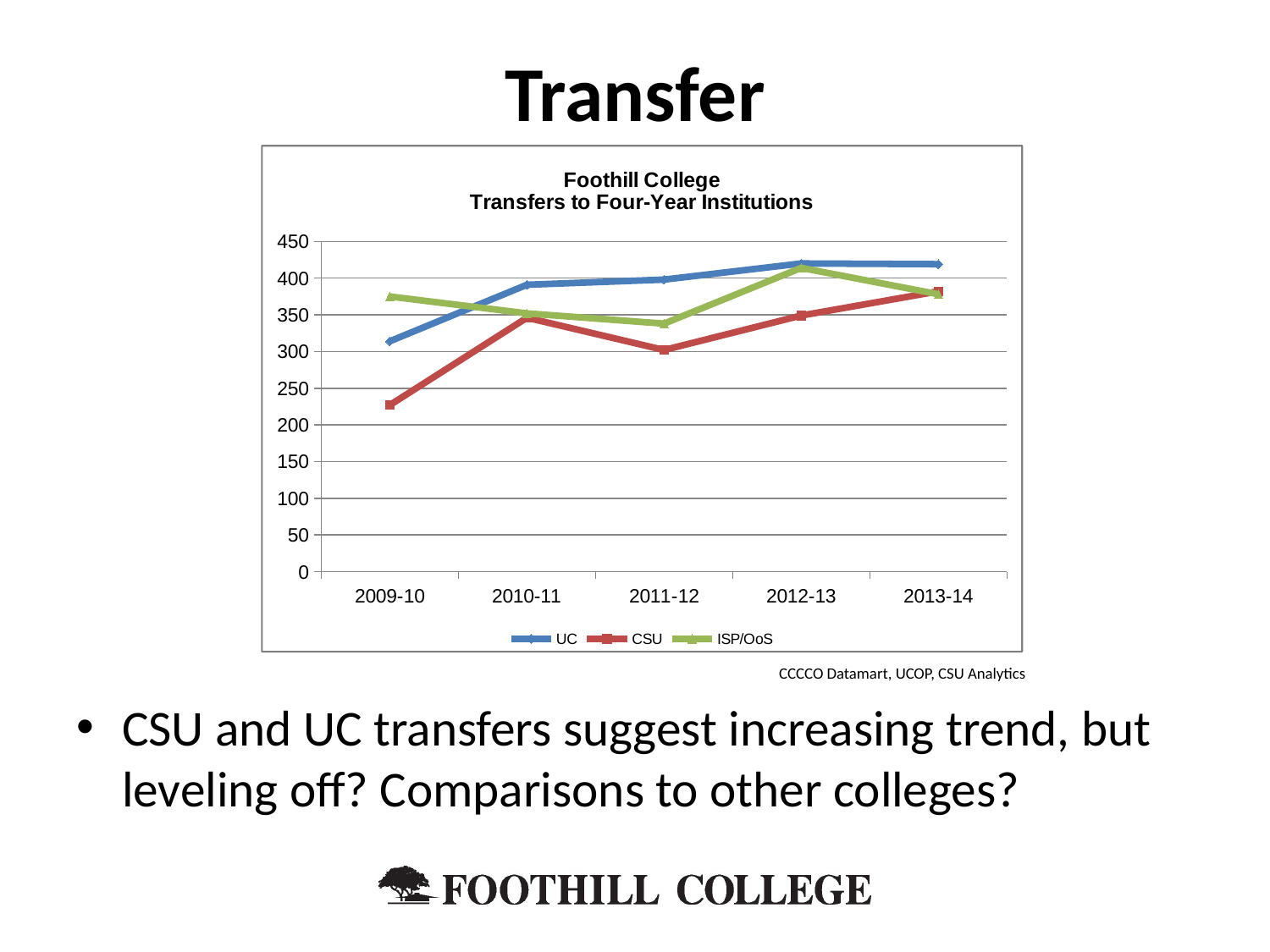
What is the title of the chart? Foothill College Transfers to Four-Year Institutions Is the value for UC in 2009-10 greater or less than 350? less Which series is drawn in green in the legend? ISP/OoS In 2009-10, which is larger, the UC value or the CSU value? UC What kind of chart is shown on the slide? line chart In which year is the CSU value lowest? 2009-10 Does the UC line rise or fall from 2009-10 to 2012-13? rise Is the value for CSU in 2011-12 greater or less than 350? less How many series does the legend list? 3 How many academic years are plotted on the x axis? 5 Is the value for CSU in 2009-10 greater or less than 250? less